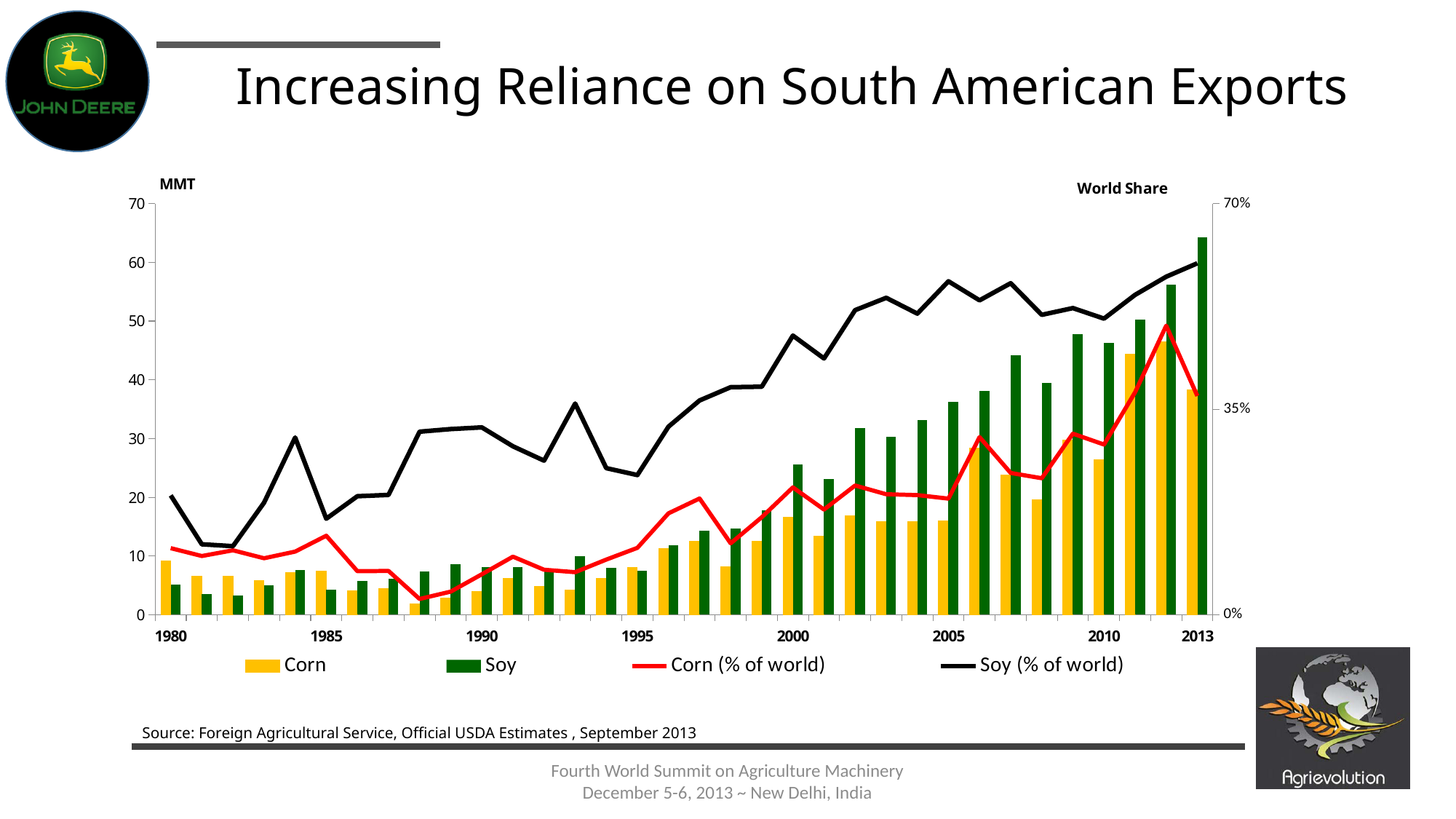
Which year has the highest Soy bar? 2013 Is the Corn (% of world) value for 1980 greater or less than 35%? less Is the Soy bar value for 2013 greater or less than 60? greater How many series does the legend list? 4 In 1980, which is larger, the Corn bar or the Soy bar? Corn Does the Soy (% of world) line generally rise or fall from 1980 to 2013? Rise Is the Corn bar value for 1980 greater or less than 10? less What kind of chart is shown on the slide? A combination bar and line chart What unit label is shown above the left axis? MMT In 2013, which is larger, the Corn bar or the Soy bar? Soy